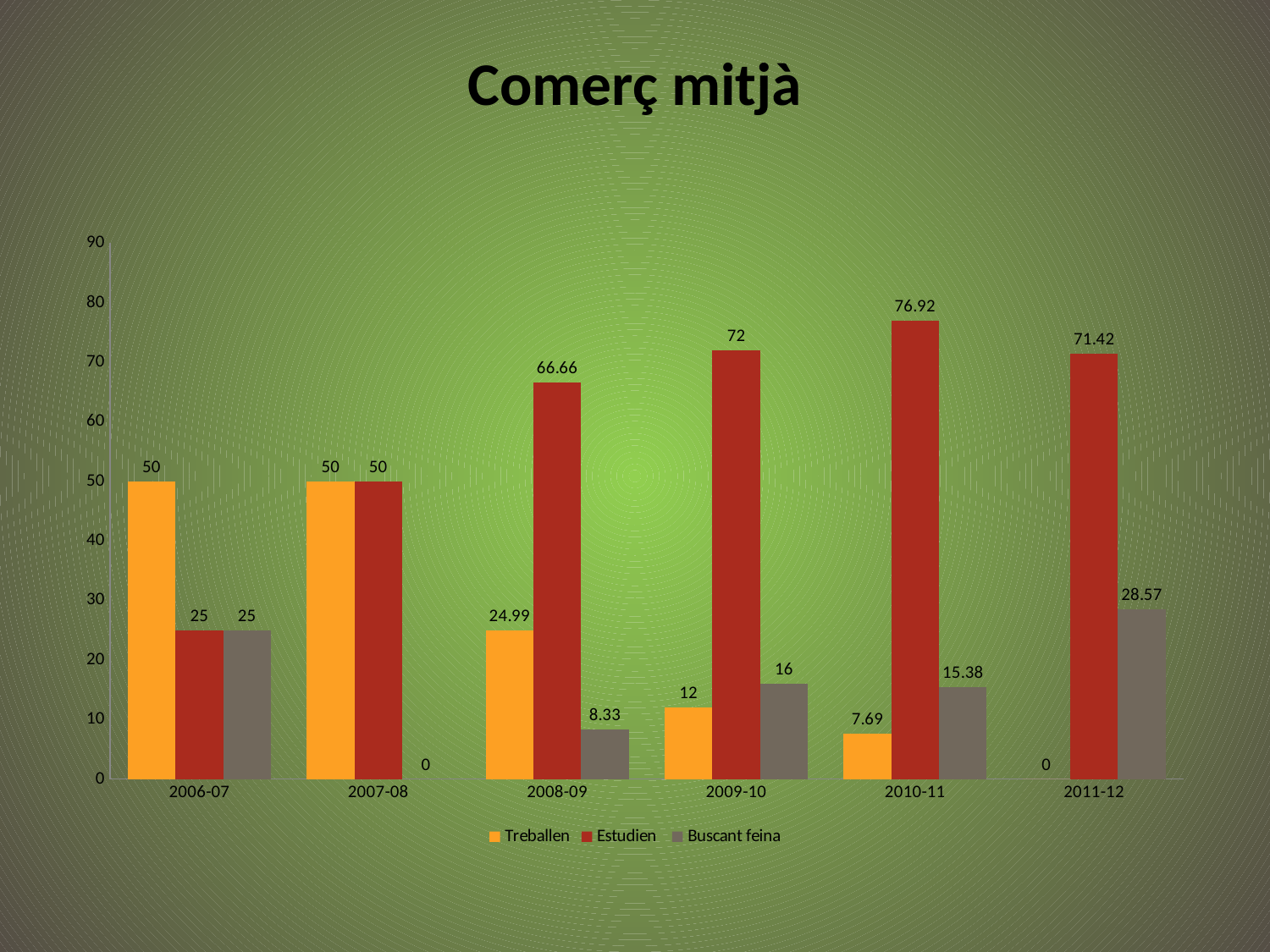
How many years are shown on the x axis? 6 Is the value for Estudien in 2008-09 greater or less than 60? greater Which is larger in 2006-07, Treballen or Estudien? Treballen What is the title of the chart? Comerç mitjà What is the difference between Estudien and Treballen in 2009-10? 60 Which year has the lowest value for Treballen? 2011-12 What kind of chart is shown? bar chart What is the value for Buscant feina in 2011-12? 28.57 Which year has the highest value for Estudien? 2010-11 What is the value for Treballen in 2008-09? 24.99 What is the value for Estudien in 2010-11? 76.92 How many series does the legend list? 3